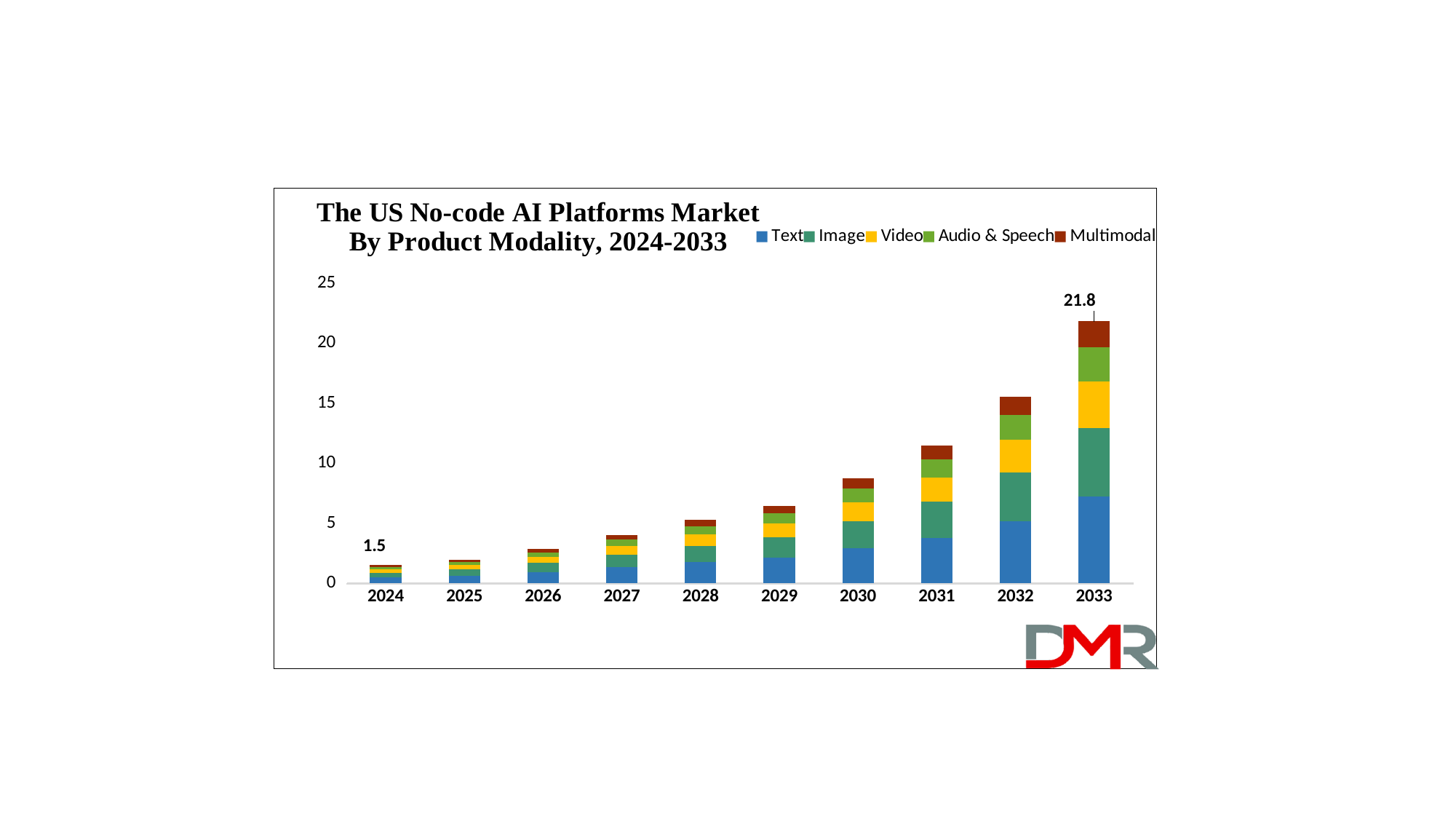
How many series does the legend list? 5 What is the total value of the stacked bar for 2024? 1.5 Is the total for 2032 greater or less than 15? greater What is the total value of the stacked bar for 2033? 21.8 Is the total for 2030 greater or less than 10? less How many years are shown on the x axis? 10 Which year has a larger total bar, 2029 or 2031? 2031 What is the difference between the 2033 total and the 2024 total? 20.3 What kind of chart is shown? Stacked bar chart Which year has the highest total bar? 2033 Do the total bar values rise or fall from 2024 to 2033? Rise Which year has the lowest total bar? 2024